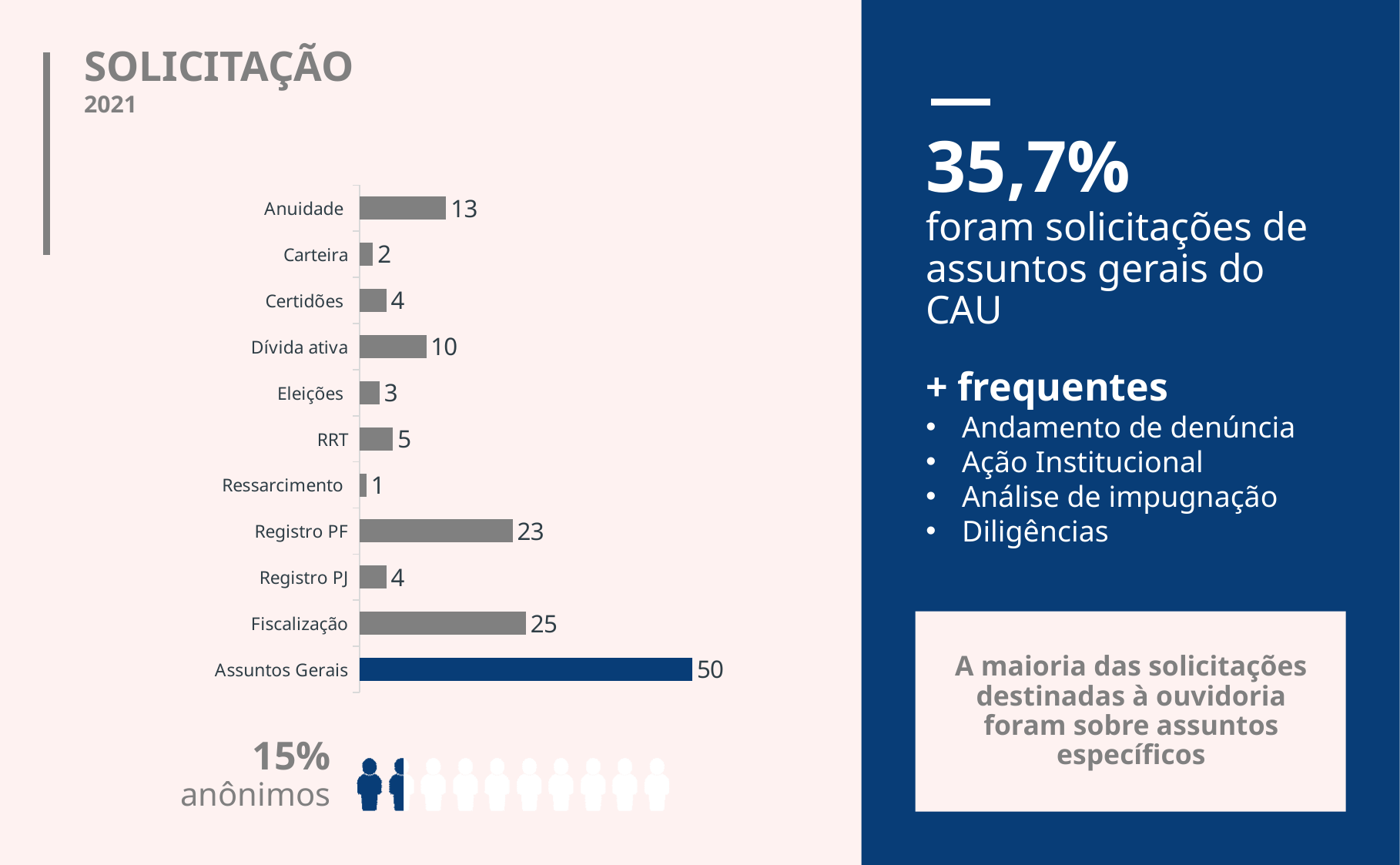
What is the value for Anuidade? 13 Which bar is shown in a different colour (dark blue) from the others? Assuntos Gerais What is the value for Dívida ativa? 10 Which is larger, RRT or Eleições? RRT What is the difference between Registro PF and Registro PJ? 19 Which category has the lowest value? Ressarcimento Which category has the highest value? Assuntos Gerais Which is larger, Fiscalização or Registro PF? Fiscalização What is the value for Registro PF? 23 How many categories are shown in the chart? 11 What is the difference between Assuntos Gerais and Fiscalização? 25 What kind of chart is shown on the slide? Bar chart